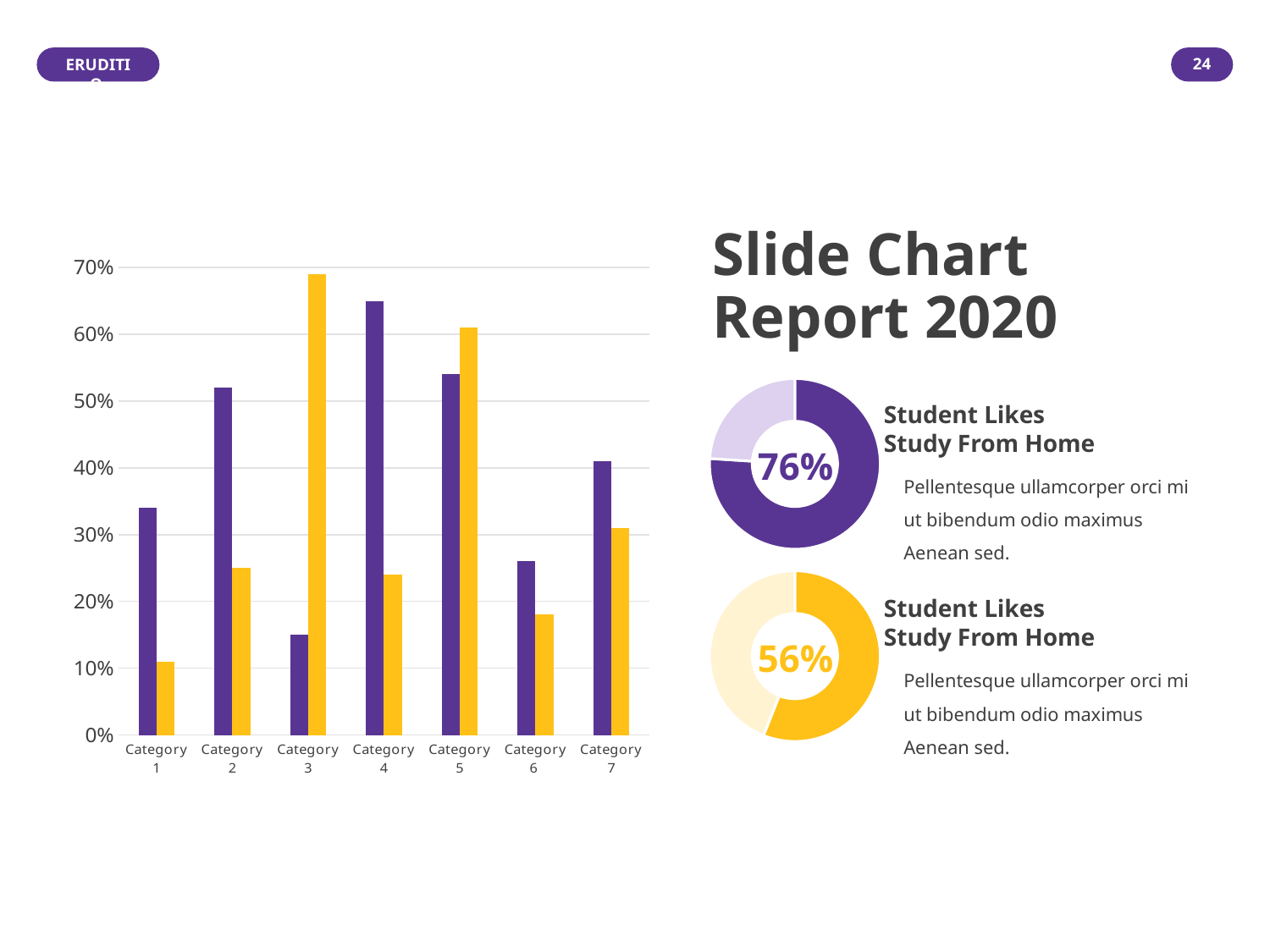
What percentage is shown in the upper (purple) donut chart on the right of the slide? 76% In the bar chart, is the purple bar for Category 1 greater or less than 30%? greater How many bars are plotted for each category in the bar chart? 2 How many categories are shown on the x axis of the bar chart? 7 In the bar chart, which category has the tallest purple bar? Category 4 In the bar chart, which category has the shortest purple bar? Category 3 In the bar chart, which category has the tallest yellow bar? Category 3 In the bar chart, which category has the shortest yellow bar? Category 1 In the bar chart, for Category 2, which bar is taller, the purple one or the yellow one? purple In the bar chart, is the yellow bar for Category 3 greater or less than 60%? greater What kind of chart is the large chart on the left of the slide? bar chart What percentage is shown in the lower (yellow) donut chart on the right of the slide? 56%